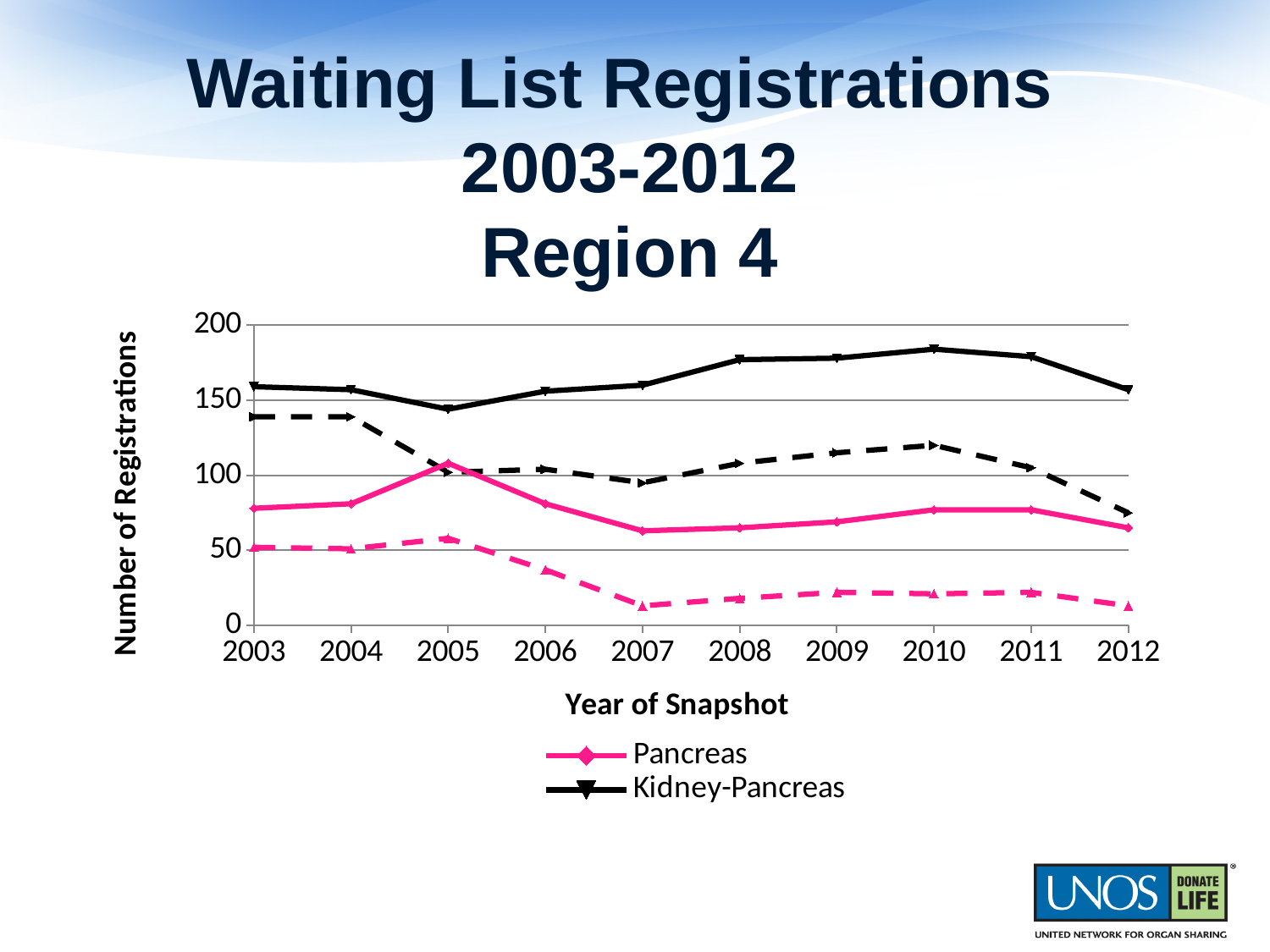
Is the value for Pancreas in 2005 greater or less than 100? greater In which year is the Kidney-Pancreas series lowest? 2005 In which year is the Pancreas series highest? 2005 How many years are shown on the x axis? 10 In which year is the Kidney-Pancreas series highest? 2010 How many series does the legend list? 2 Is the value for Kidney-Pancreas in 2008 greater or less than 150? greater Is the value for Kidney-Pancreas in 2005 greater or less than 150? less What is the title of the x axis? Year of Snapshot Does the Kidney-Pancreas series rise or fall from 2010 to 2012? fall What kind of chart is shown on the slide? line chart Which series has the larger value in 2012, Pancreas or Kidney-Pancreas? Kidney-Pancreas